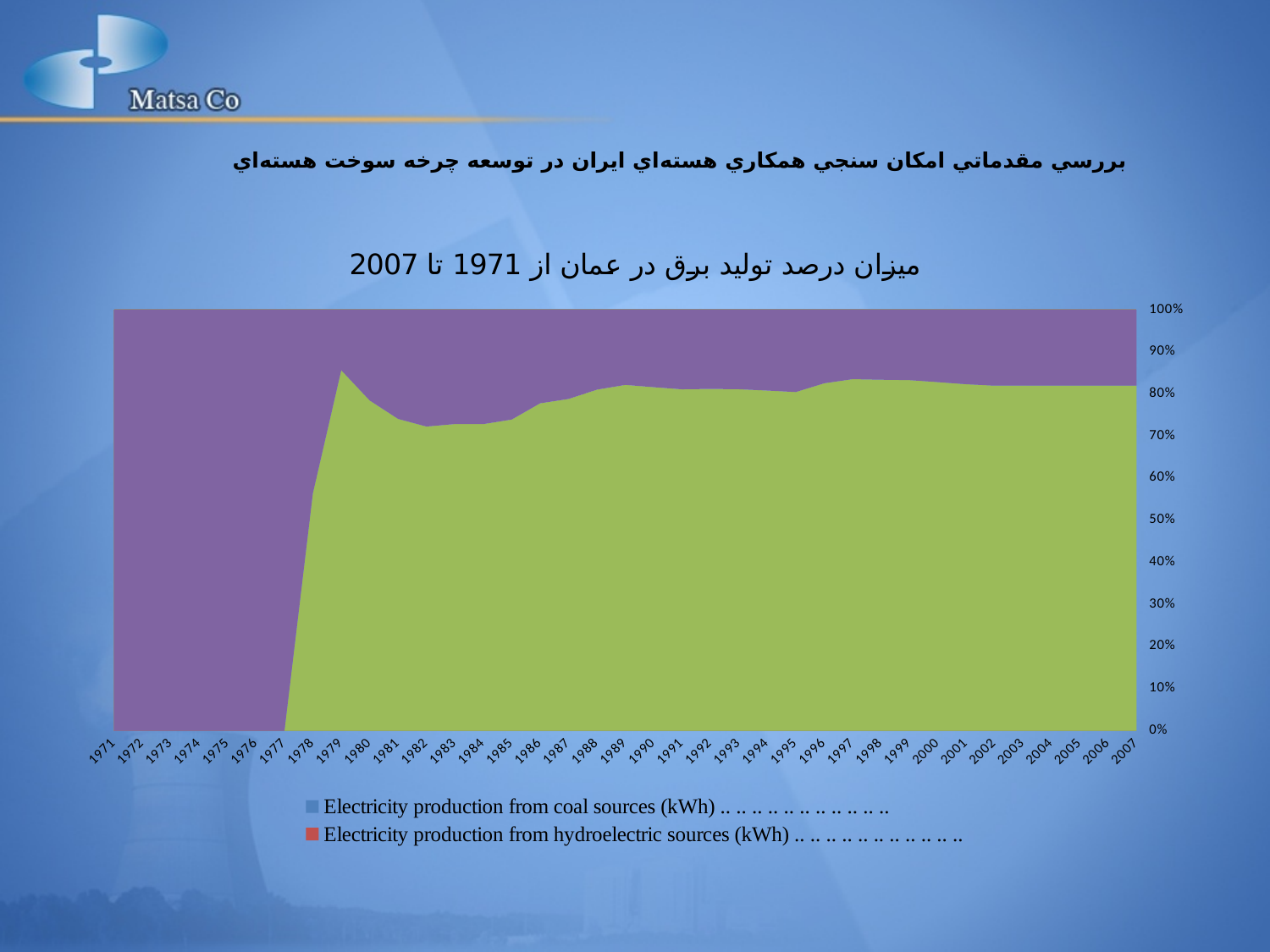
Is the share of the green area in 1975 greater or less than 10%? less Is the share of the green area in 1979 greater or less than 80%? greater How many years are shown along the x axis of the chart? 37 What is the last year shown on the x axis? 2007 What is the first legend entry of the chart? Electricity production from coal sources (kWh) .. .. .. .. .. .. .. .. .. .. .. What is the highest value shown on the y axis? 100% Is the share of the green area in 1983 greater or less than 80%? less How many series does the legend list? 2 Does the share of the green area rise or fall between 1977 and 1979? rise What kind of chart is shown on the slide? Stacked area chart What is the first year shown on the x axis? 1971 In which year does the green area reach its highest share? 1979